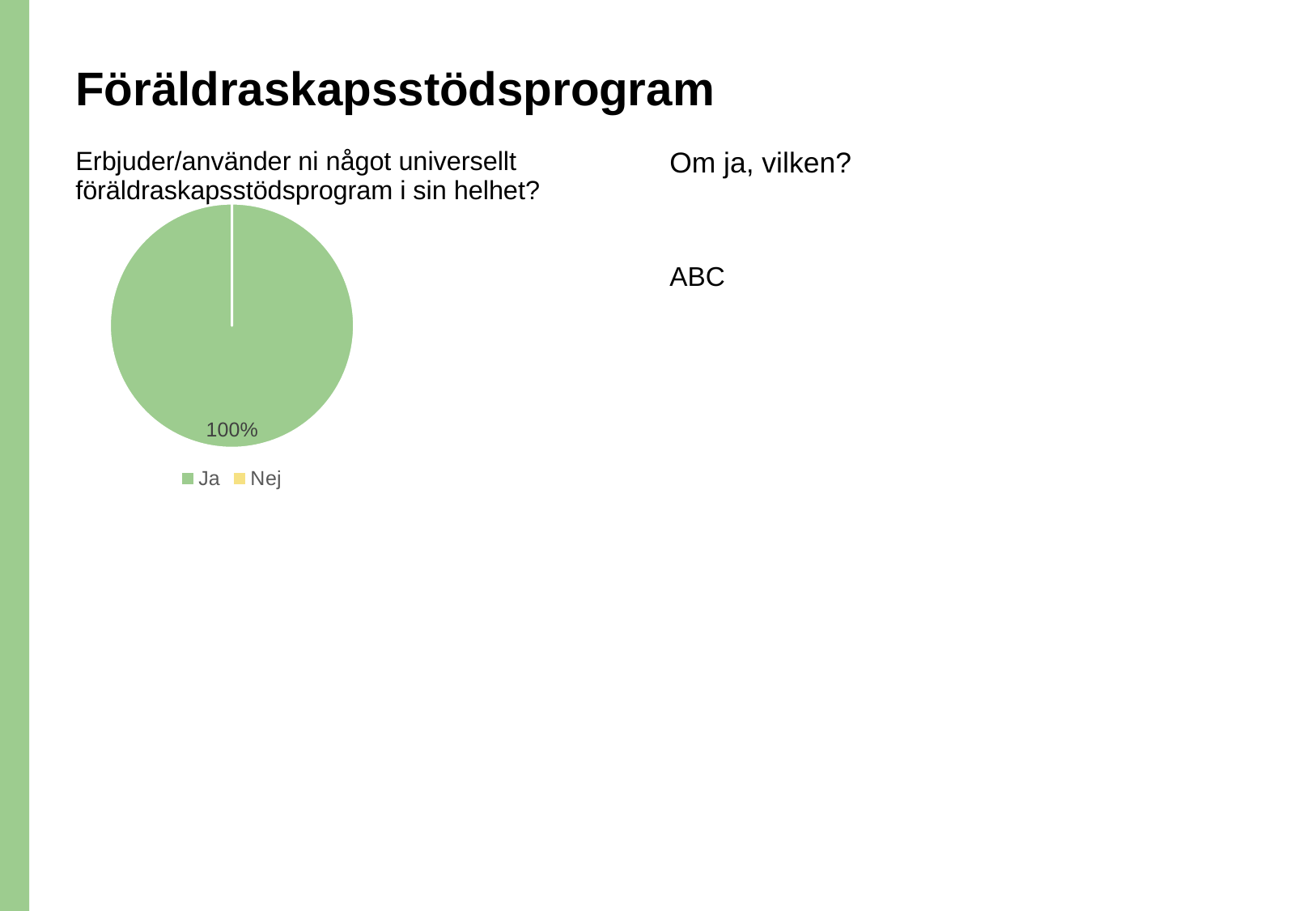
How many entries does the legend list? 2 Which category has the largest share of the pie? Ja What colour is the "Ja" slice of the pie? green What kind of chart is shown on the slide? pie chart What is the only data label printed on the pie chart? 100% Which is larger, the share for "Ja" or the share for "Nej"? Ja What are the two legend entries of the pie chart? Ja, Nej What share of the pie does "Ja" have? 100%